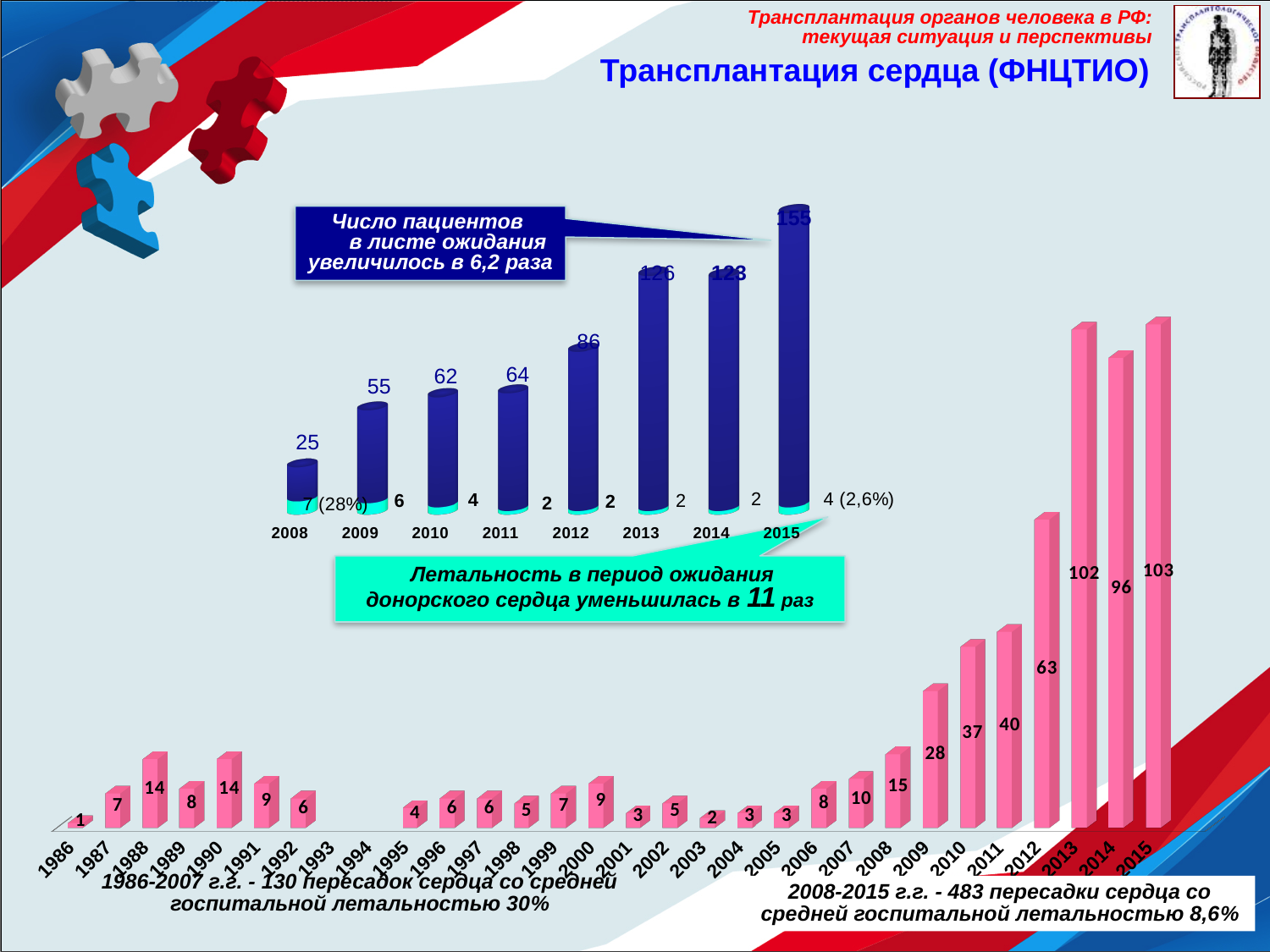
In the pink bar chart at the bottom of the slide, what is the value for 1986? 1 In the blue bar chart in the upper middle of the slide, which year has the lowest value for the tall blue bars? 2008 In the blue bar chart in the upper middle of the slide, what is the value of the tall blue bar for 2008? 25 In the blue bar chart in the upper middle of the slide, what is the difference between the tall blue bar values for 2013 and 2012? 40 In the pink bar chart at the bottom of the slide, what is the difference between the values for 2015 and 2014? 7 In the pink bar chart at the bottom of the slide, which is larger, the value for 2010 or the value for 2011? 2011 What kind of chart is the pink chart at the bottom of the slide? Bar chart In the pink bar chart at the bottom of the slide, what is the value for 2013? 102 In the pink bar chart at the bottom of the slide, which year has the highest value? 2015 How many years are shown on the x axis of the blue bar chart in the upper middle of the slide? 8 In the blue bar chart in the upper middle of the slide, what is the value of the tall blue bar for 2015? 155 In the pink bar chart at the bottom of the slide, what is the value for 2012? 63